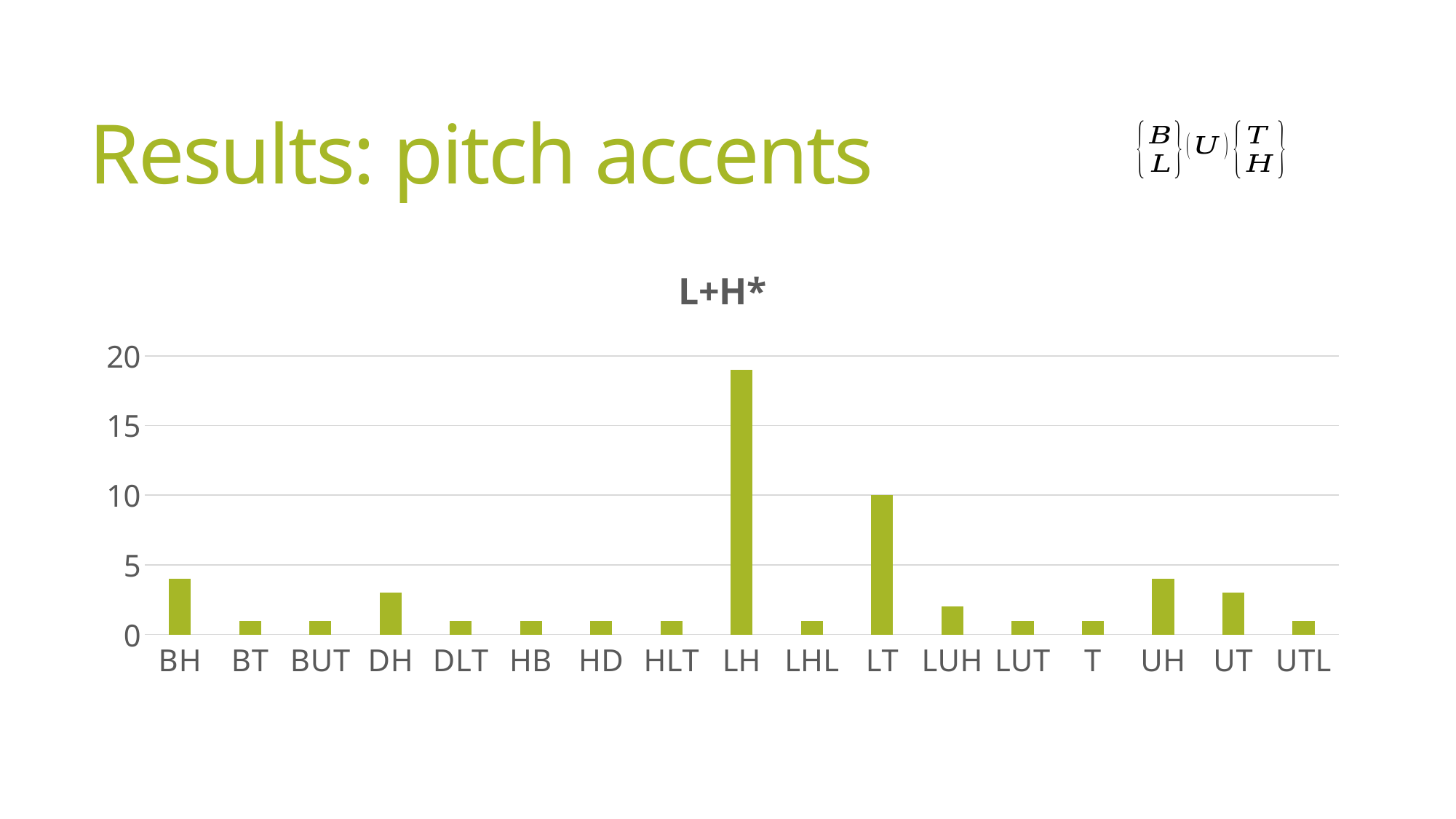
Which is larger, the value for DH or the value for DLT? DH What is the value for LT in the chart? 10 Which category has the highest value in the chart? LH What is the highest value shown on the y axis of the chart? 20 Which is larger, the value for BH or the value for BT? BH How many categories are shown on the x axis of the chart? 17 Which is larger, the value for LH or the value for LT? LH Is the value for BH greater or less than 5? less What is the title of the chart? L+H* What kind of chart is shown on the slide? bar chart Is the value for LH greater or less than 15? greater Is the value for UH greater or less than 5? less